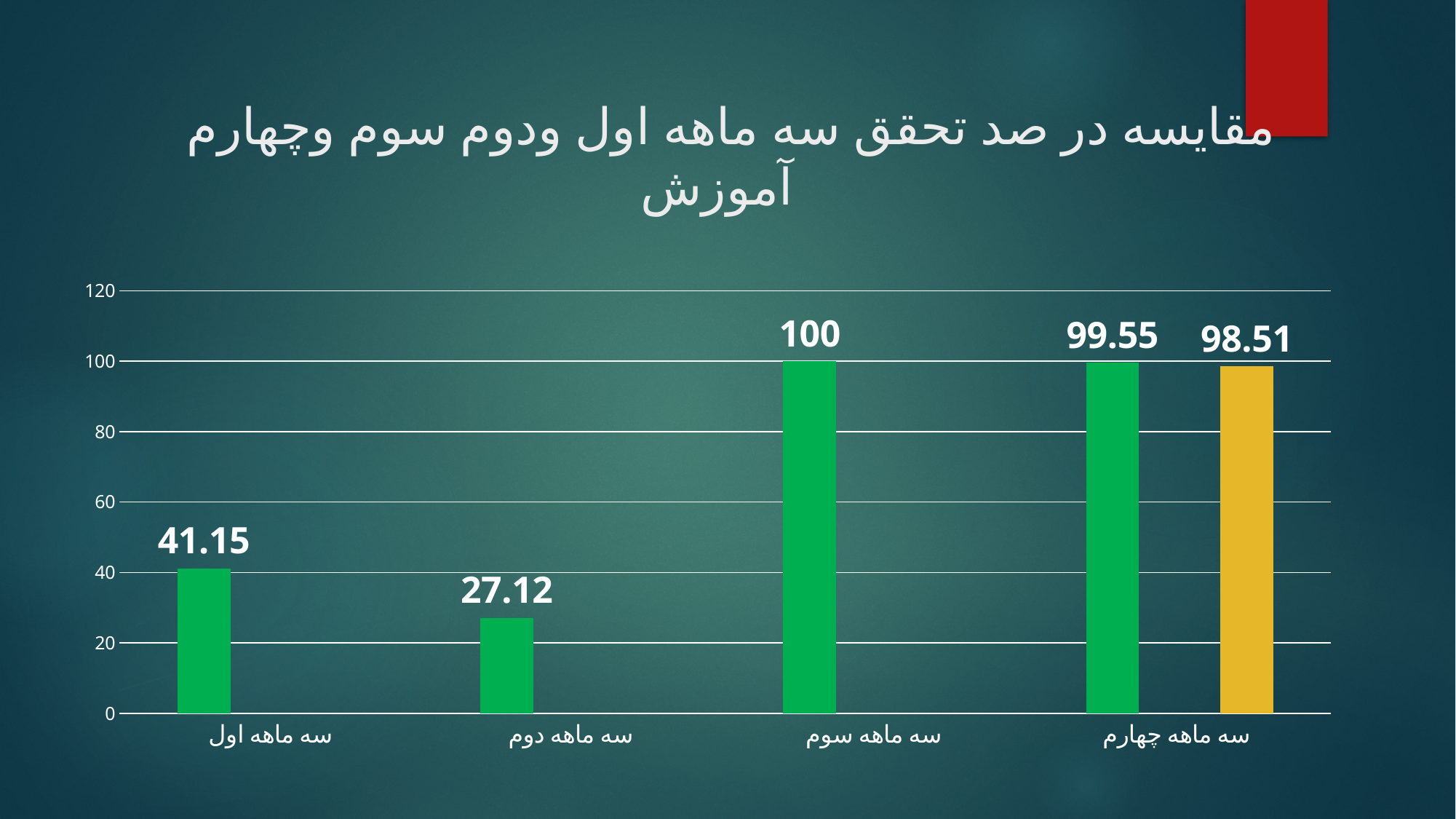
What is the value for سه ماهه سوم? 100 What is the value for سه ماهه دوم? 27.12 Which is larger, the value for سه ماهه اول or سه ماهه دوم? سه ماهه اول What kind of chart is shown on the slide? bar chart What is the difference between the values for سه ماهه اول and سه ماهه دوم? 14.03 What is the value shown on the yellow bar at the far right of the chart? 98.51 What is the value for سه ماهه اول? 41.15 Is the value for سه ماهه اول greater or less than 60? less Which labelled category has the highest value? سه ماهه سوم How many bars are plotted in the chart? 5 Which category has the lowest value? سه ماهه دوم